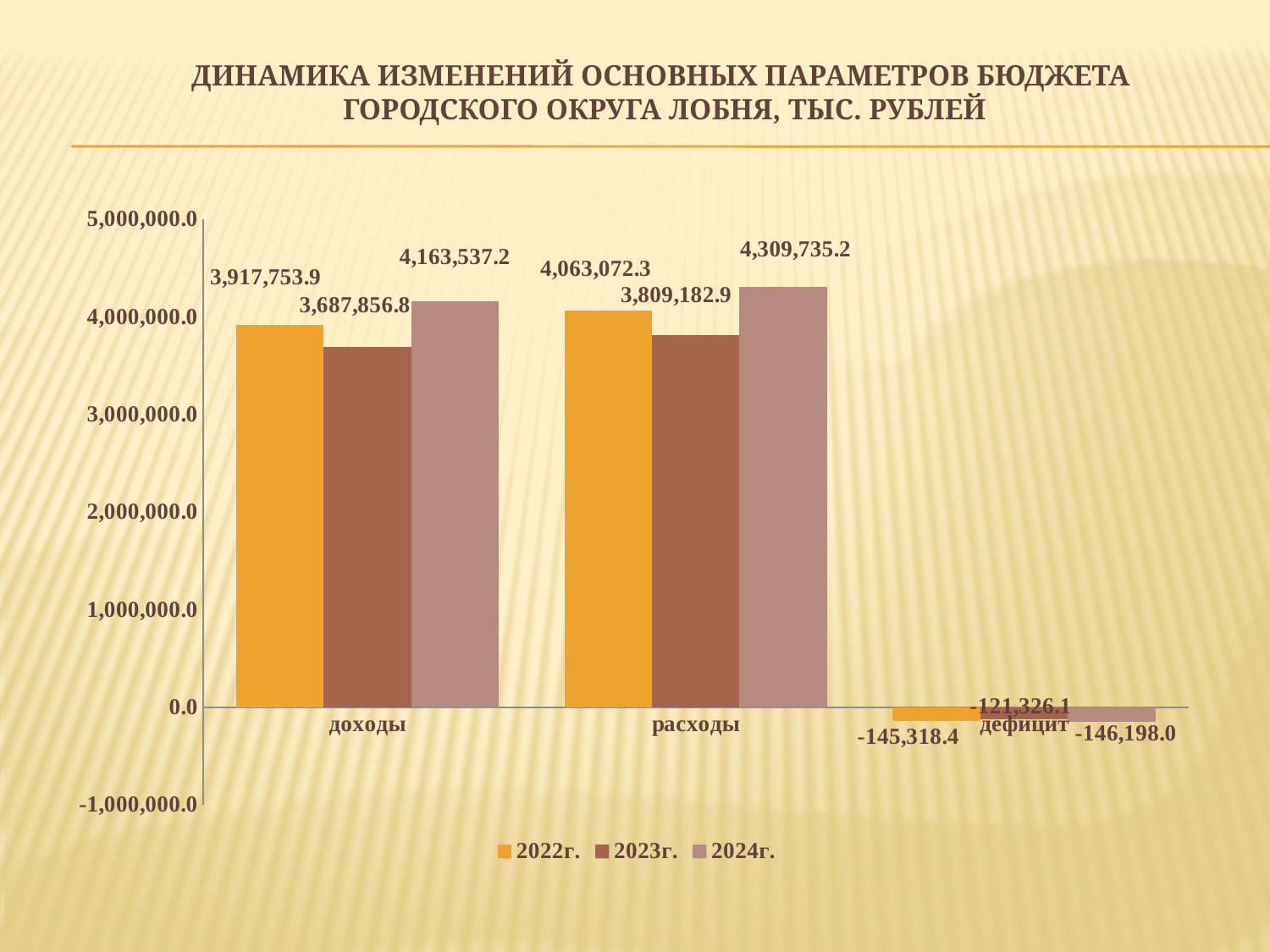
Which year has the highest value for расходы? 2024г. How many categories are shown on the x axis? 3 Which is larger: расходы in 2022г. or доходы in 2022г.? расходы in 2022г. What is the value for доходы in 2022г.? 3,917,753.9 What is the difference between расходы and доходы in 2024г.? 146,198.0 What is the value for доходы in 2023г.? 3,687,856.8 What is the difference between доходы in 2024г. and доходы in 2023г.? 475,680.4 What is the value for дефицит in 2023г.? -121,326.1 What is the value for расходы in 2024г.? 4,309,735.2 How many series does the legend list? 3 What kind of chart is shown on the slide? bar chart Which year has the lowest value for доходы? 2023г.